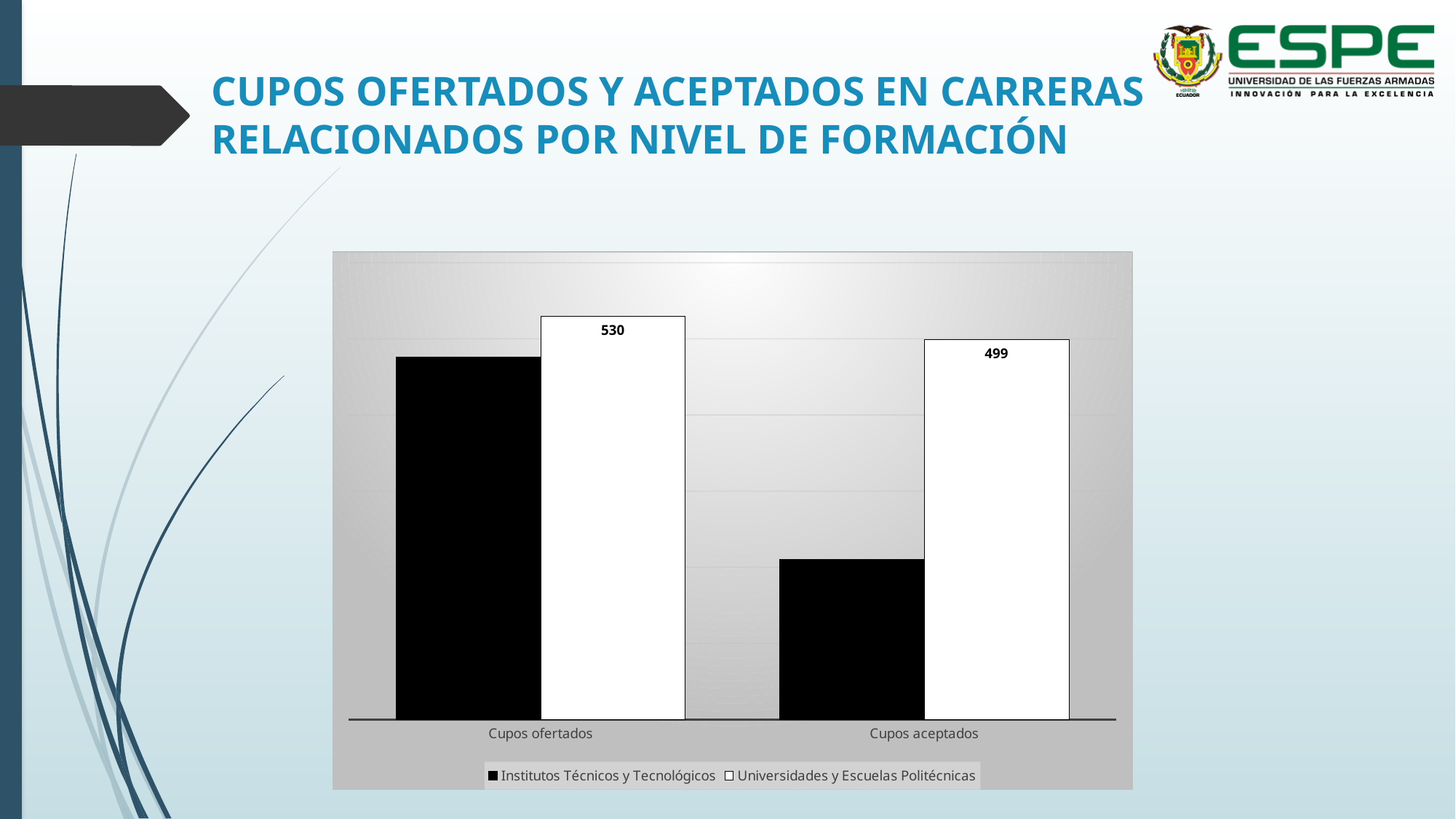
In the Cupos aceptados category, which series has the taller bar? Universidades y Escuelas Politécnicas In which category is the Universidades y Escuelas Politécnicas value higher, Cupos ofertados or Cupos aceptados? Cupos ofertados For Institutos Técnicos y Tecnológicos, which category has the taller bar, Cupos ofertados or Cupos aceptados? Cupos ofertados What kind of chart is shown on the slide? Bar chart How many series does the chart legend list? 2 Which bar in the chart is the tallest? Universidades y Escuelas Politécnicas, Cupos ofertados How many categories are shown on the x axis of the chart? 2 What is the value for Universidades y Escuelas Politécnicas in the Cupos aceptados category? 499 What is the value for Universidades y Escuelas Politécnicas in the Cupos ofertados category? 530 Which bar in the chart is the shortest? Institutos Técnicos y Tecnológicos, Cupos aceptados What is the difference between the Universidades y Escuelas Politécnicas values for Cupos ofertados and Cupos aceptados? 31